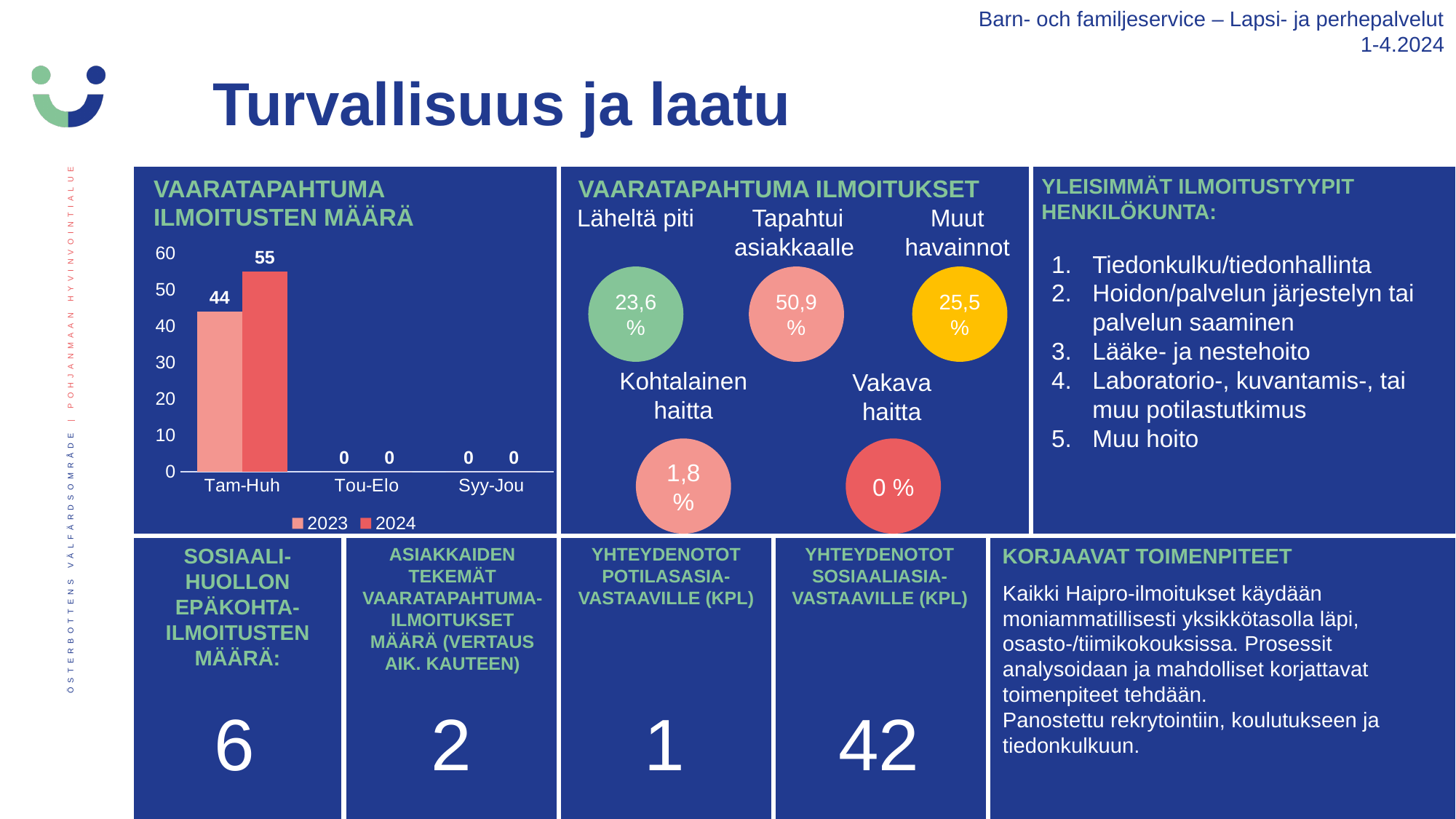
What kind of chart is used to show the number of incident reports (Vaaratapahtuma ilmoitusten määrä)? bar chart What is the value for 2023 in the Tam-Huh category? 44 What is the value for 2024 in the Syy-Jou category? 0 What is the value for 2023 in the Tou-Elo category? 0 What is the title of the bar chart on the slide? VAARATAPAHTUMA ILMOITUSTEN MÄÄRÄ How many series does the legend of the bar chart list? 2 Which category has the highest value for the 2024 series? Tam-Huh What is the value for 2024 in the Tam-Huh category? 55 Is the 2023 value for Tam-Huh greater or less than 40? greater What is the difference between the 2024 and 2023 values for Tam-Huh? 11 For Tam-Huh, which series has the larger value, 2023 or 2024? 2024 How many categories are shown on the x axis of the bar chart? 3